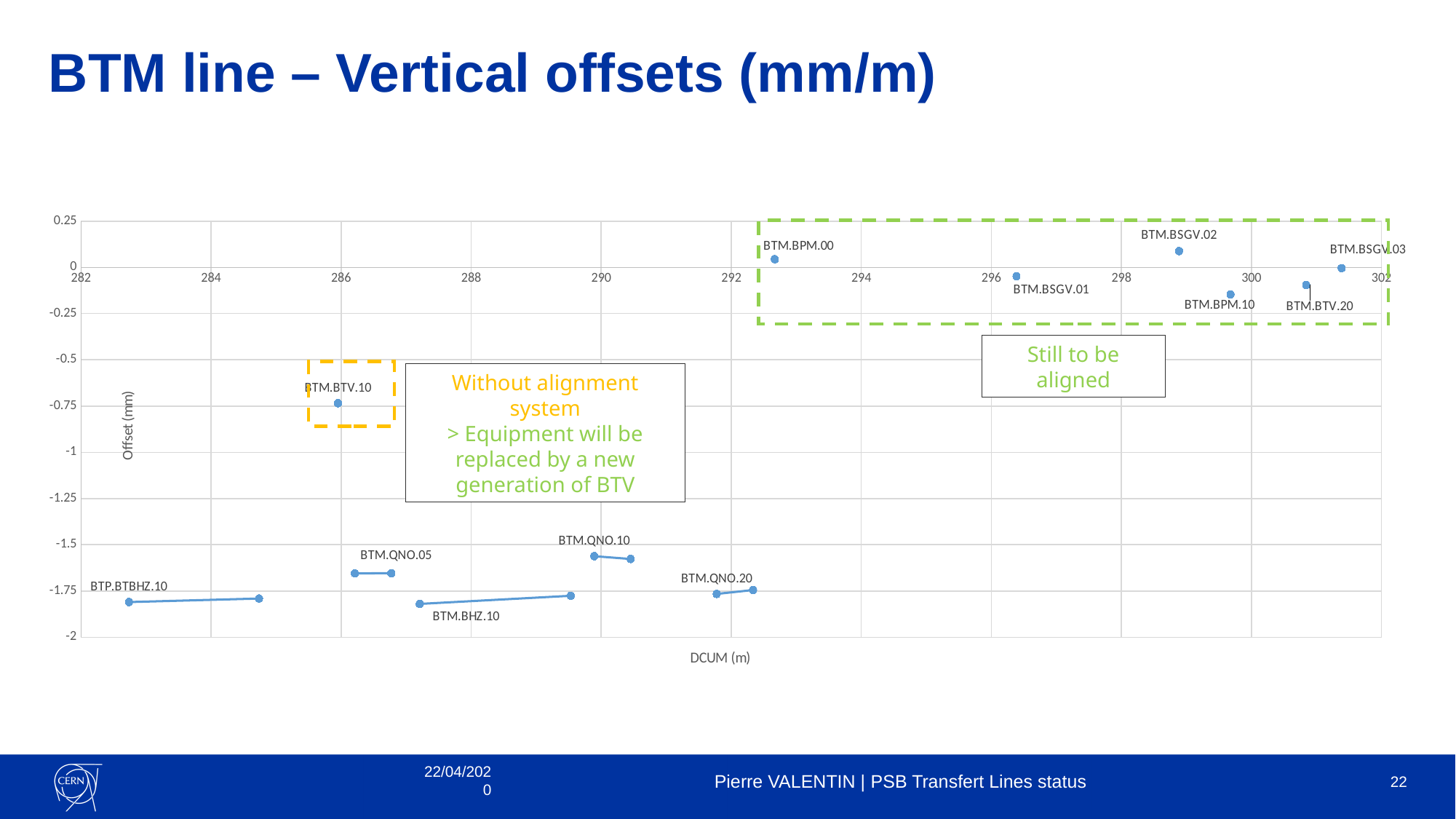
Is the offset for BTM.QNO.05 greater or less than -1.5? less Which labeled element has the highest vertical offset on the chart? BTM.BSGV.02 Is the offset for BTM.BTV.10 greater or less than -0.5? less What is the label of the y axis of the chart? Offset (mm) Which has the larger offset, BTM.BTV.10 or BTM.QNO.05? BTM.BTV.10 Which has the larger offset, BTM.QNO.10 or BTM.QNO.20? BTM.QNO.10 What is the label of the x axis of the chart? DCUM (m) How many labeled elements are plotted on the chart? 12 What kind of chart is shown on the slide? scatter chart How many elements are enclosed in the green dashed 'Still to be aligned' box? 6 Is the offset for BTM.BPM.10 greater or less than 0? less